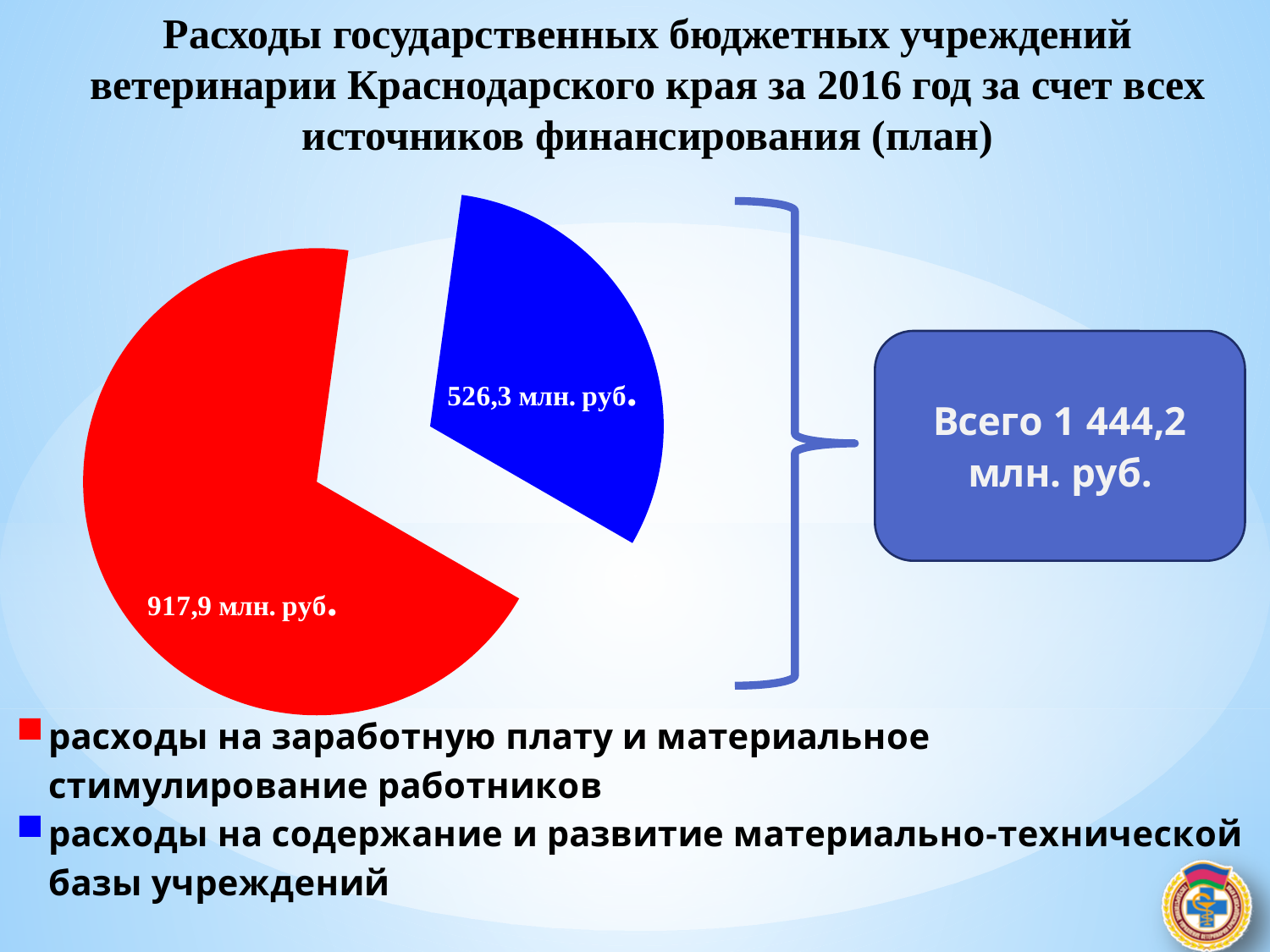
What colour represents расходы на содержание и развитие материально-технической базы учреждений? blue What type of chart is shown on the slide? pie chart How many entries does the legend list? 2 What is the value of the blue slice (расходы на содержание и развитие материально-технической базы учреждений)? 526,3 млн. руб. How many slices does the pie chart have? 2 What is the difference between the red slice (917,9 млн. руб.) and the blue slice (526,3 млн. руб.)? 391,6 млн. руб. What total amount is shown in the box to the right of the pie chart? Всего 1 444,2 млн. руб. Which category has the smallest share of expenses? расходы на содержание и развитие материально-технической базы учреждений What is the value of the red slice (расходы на заработную плату и материальное стимулирование работников)? 917,9 млн. руб. For which year does the chart show the planned expenses? 2016 Which category has the largest share of expenses? расходы на заработную плату и материальное стимулирование работников Which is larger: expenses on salaries (red) or expenses on the material-technical base (blue)? expenses on salaries (red)